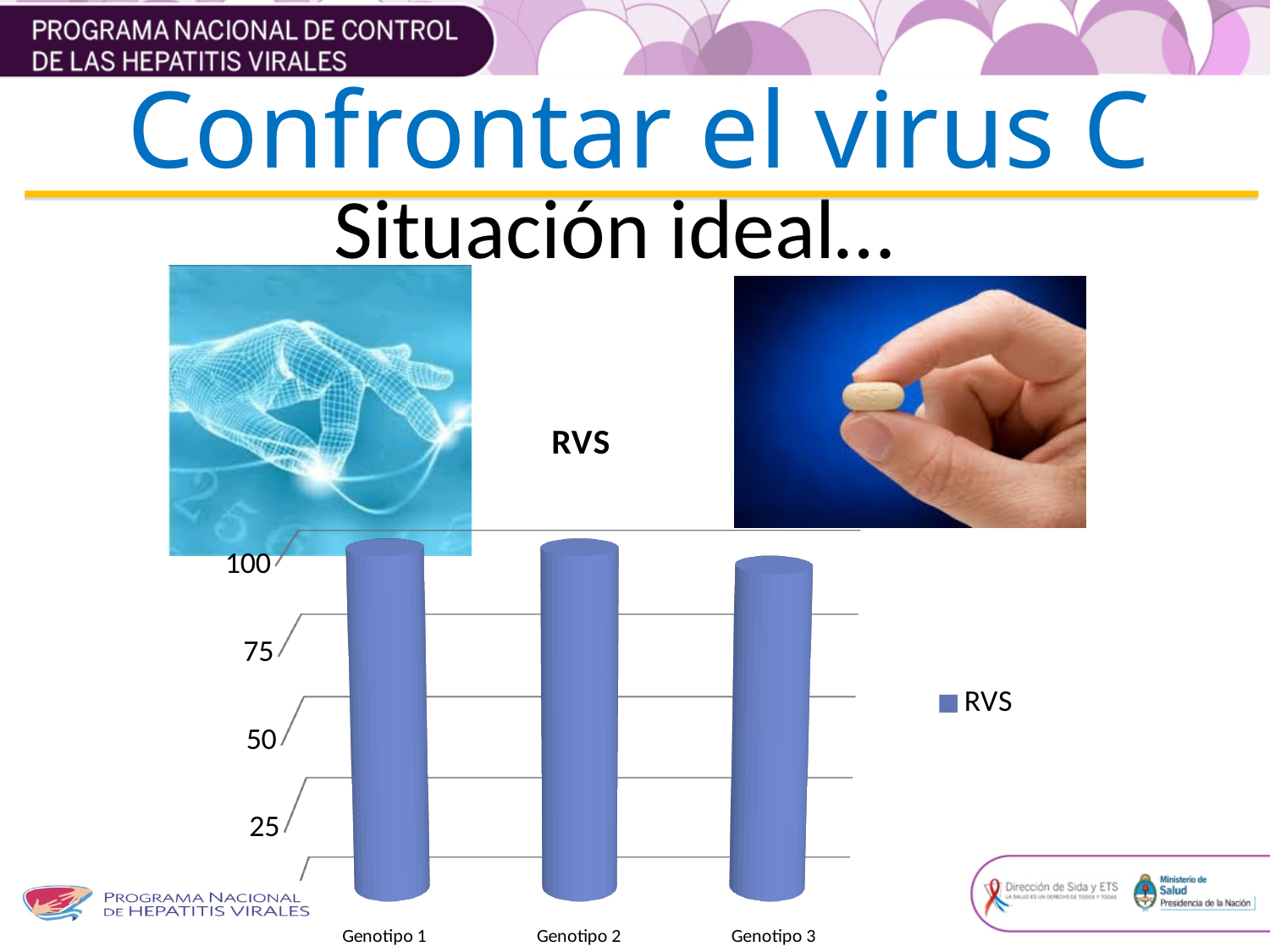
Is the value for Genotipo 1 greater or less than 75? greater Which is larger, the value for Genotipo 1 or Genotipo 3? Genotipo 1 How many series does the chart legend list? 1 What series name appears in the chart legend? RVS What is the title of the chart? RVS Is the value for Genotipo 3 greater or less than 75? greater Which category has the lowest RVS value? Genotipo 3 How many categories are shown on the x axis of the chart? 3 Is the value for Genotipo 3 greater or less than 25? greater What type of chart is shown on the slide? bar chart